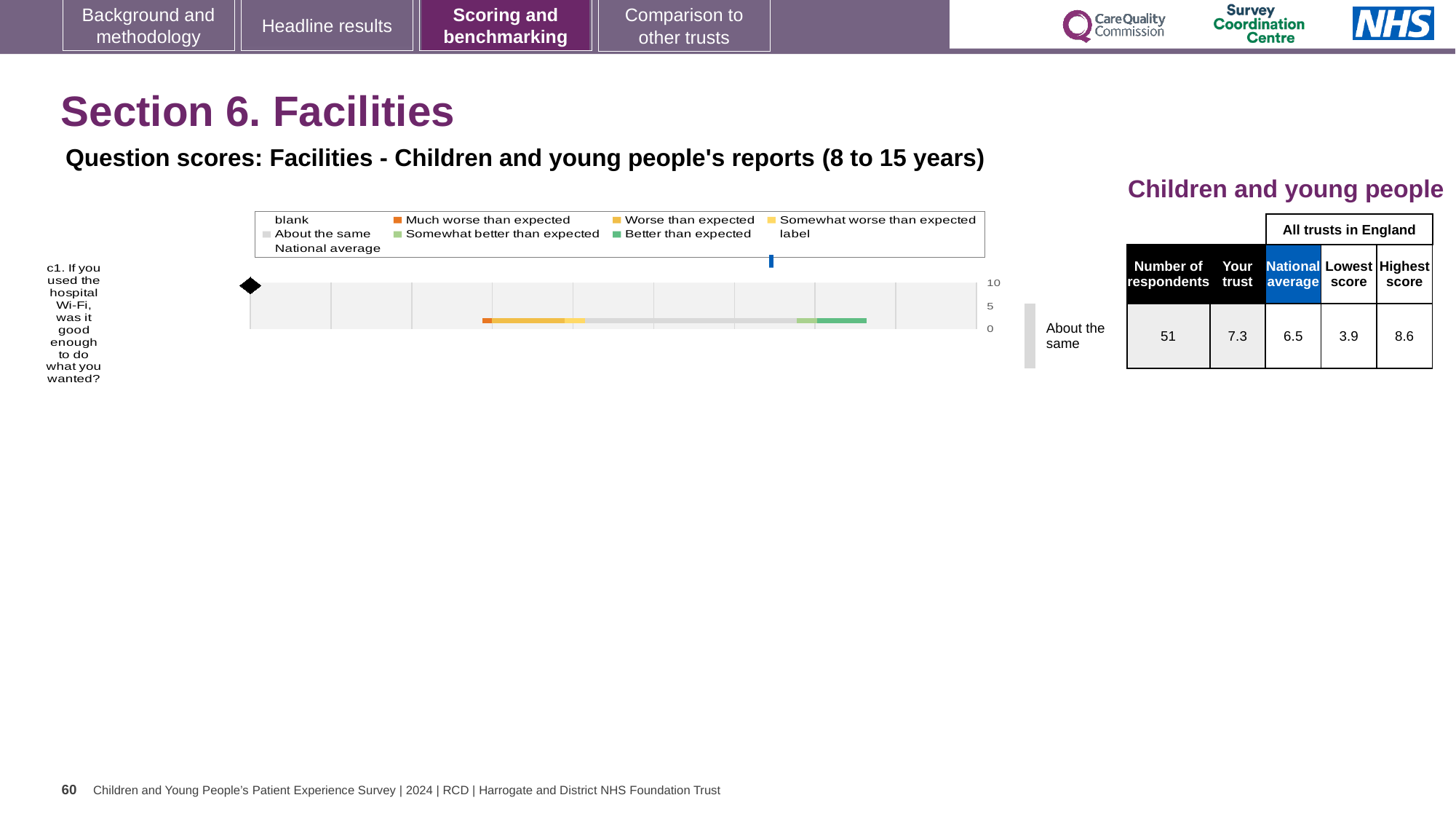
What is the highest value shown on the chart's axis? 10 What is the lowest score among all trusts in England for question c1? 3.9 What is the highest score among all trusts in England for question c1? 8.6 What is the national average score for question c1 about the hospital Wi-Fi? 6.5 Which colour does the chart legend use for 'Much worse than expected'? orange What kind of chart is shown on the slide? bar chart Which is larger for question c1: the 'Your trust' score or the national average? Your trust What is the difference between the 'Your trust' score and the national average for question c1? 0.8 What rating is given for question c1 (hospital Wi-Fi) in the 'About the same' label next to the chart? About the same How many question categories are plotted on the chart? 1 What is the 'Your trust' score for question c1 about the hospital Wi-Fi? 7.3 How many respondents answered question c1 about the hospital Wi-Fi? 51